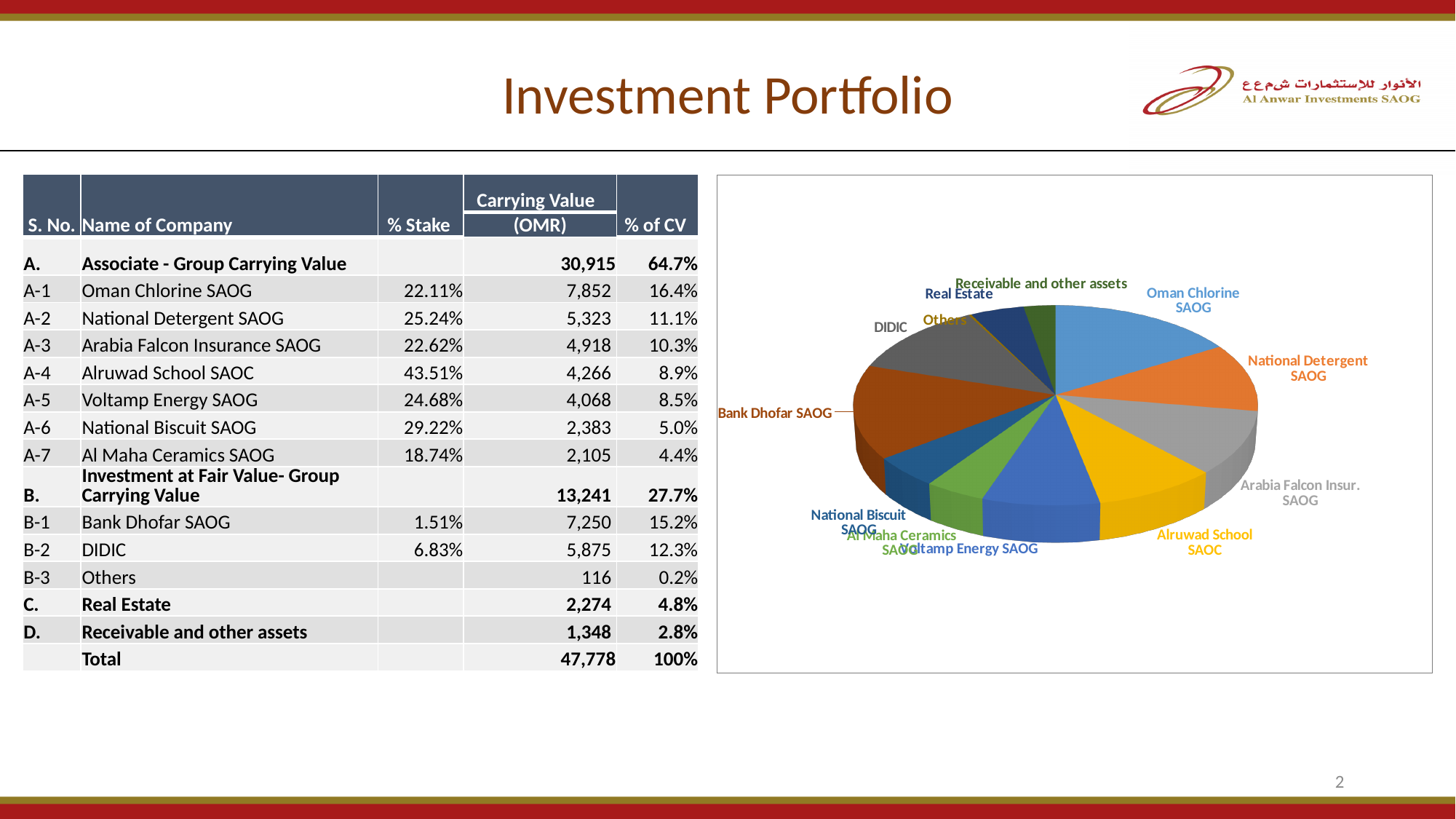
According to the slide, what share of the carrying value does the Others slice represent? 0.2% Which slice of the pie chart is the smallest? Others What is the title of the slide containing the pie chart? Investment Portfolio What is the difference in carrying value (OMR) between Oman Chlorine SAOG and National Detergent SAOG? 2,529 What is the carrying value (OMR) for DIDIC shown on the slide? 5,875 How many slices does the pie chart have? 12 According to the slide, what share of the carrying value does the Bank Dhofar SAOG slice represent? 15.2% According to the slide, what share of the carrying value does the Oman Chlorine SAOG slice represent? 16.4% In the pie chart, which slice is larger: Oman Chlorine SAOG or Others? Oman Chlorine SAOG In the pie chart, which slice is larger: Bank Dhofar SAOG or Real Estate? Bank Dhofar SAOG In the pie chart, which slice is larger: National Detergent SAOG or Receivable and other assets? National Detergent SAOG What kind of chart is shown on the right side of the slide? pie chart